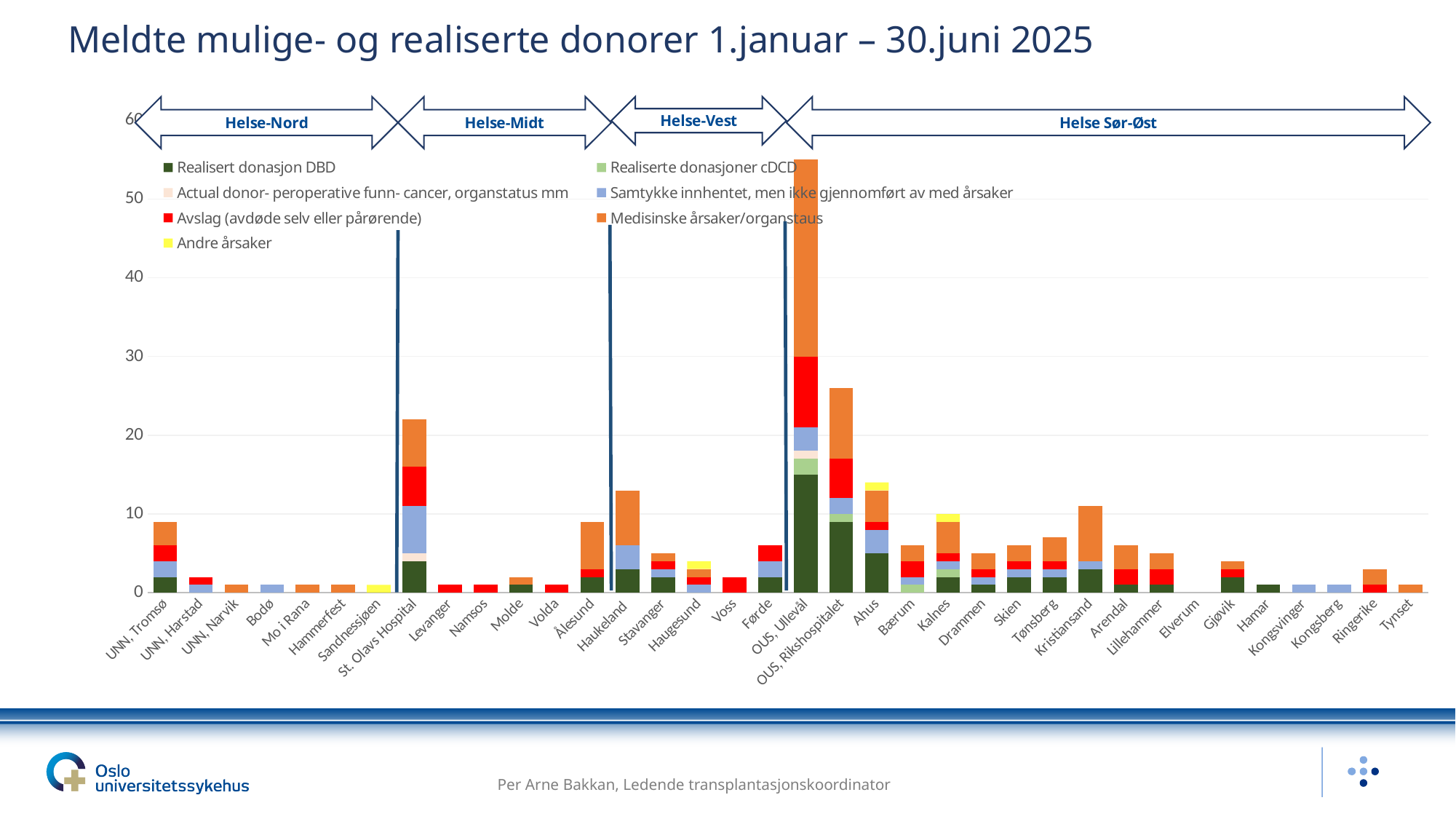
How many series does the chart legend list? 7 What kind of chart is shown on the slide? stacked bar chart Is the total value for OUS, Rikshospitalet greater or less than 20? greater Which hospital has the tallest stacked bar? OUS, Ullevål How many hospitals (categories) are shown along the x axis? 36 Is the total value for Kristiansand greater or less than 20? less What is the title of the chart on the slide? Meldte mulige- og realiserte donorer 1.januar – 30.juni 2025 Which colour represents the series 'Avslag (avdøde selv eller pårørende)' in the legend? red Is the total value for Haukeland greater or less than 10? greater Which has the taller stacked bar, St. Olavs Hospital or Haukeland? St. Olavs Hospital Which has the taller stacked bar, OUS, Rikshospitalet or Ahus? OUS, Rikshospitalet